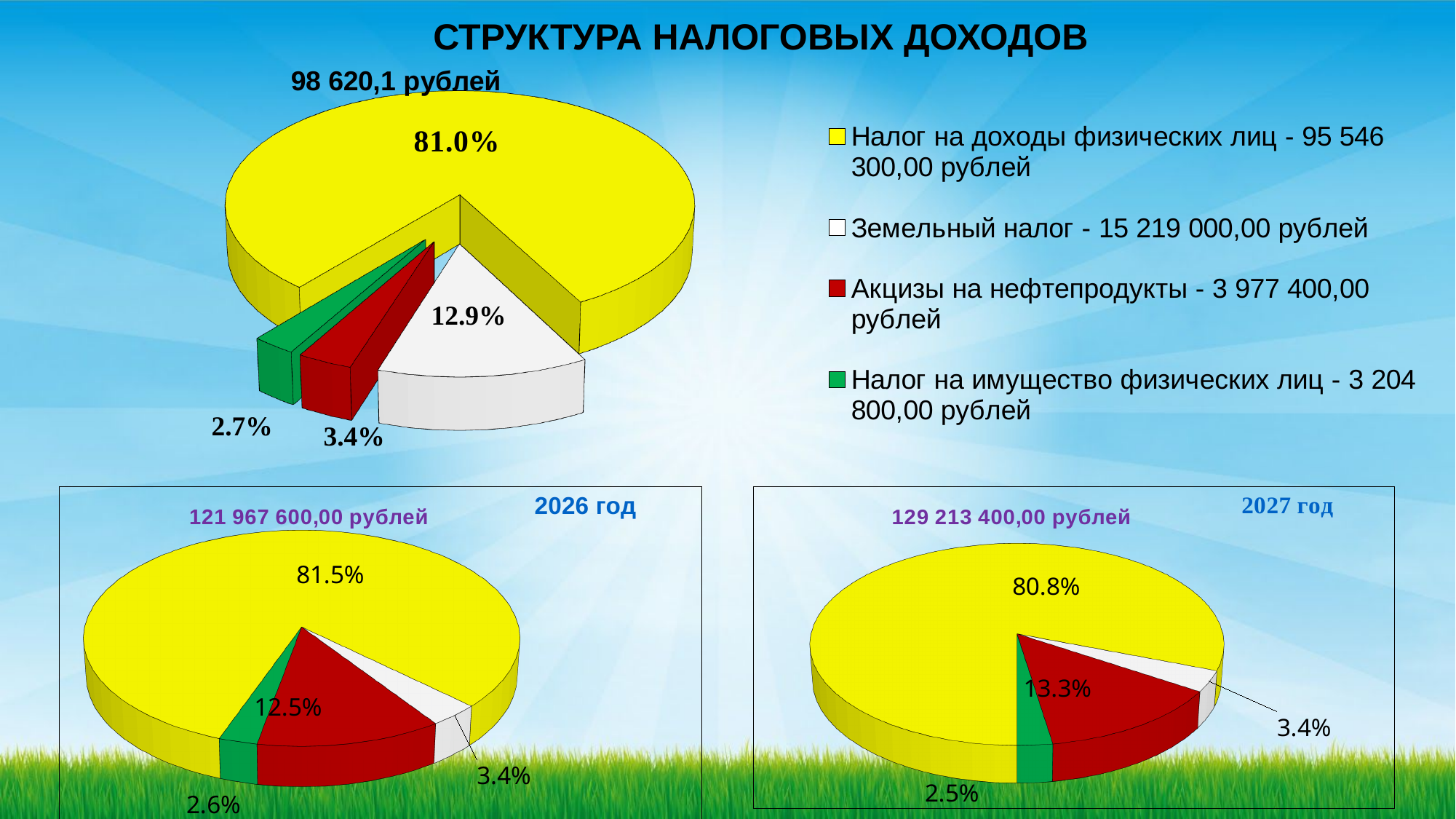
In the 2027 год pie chart, what is the smallest share labelled? 2.5% In the top pie chart, what share is labelled on the white slice? 12.9% In the top pie chart, what share is labelled on the red slice? 3.4% In the top pie chart, what share is labelled on the green slice? 2.7% What kind of chart is shown at the top of the slide? pie chart How many entries does the legend of the top pie chart list? 4 In the 2026 год pie chart, what is the largest share labelled? 81.5% What total amount is printed above the 2027 год pie chart? 129 213 400,00 рублей In the top pie chart, which category has the smallest share? Налог на имущество физических лиц According to the legend of the top chart, what is the value for Земельный налог? 15 219 000,00 рублей In the top pie chart, which category has the largest share? Налог на доходы физических лиц